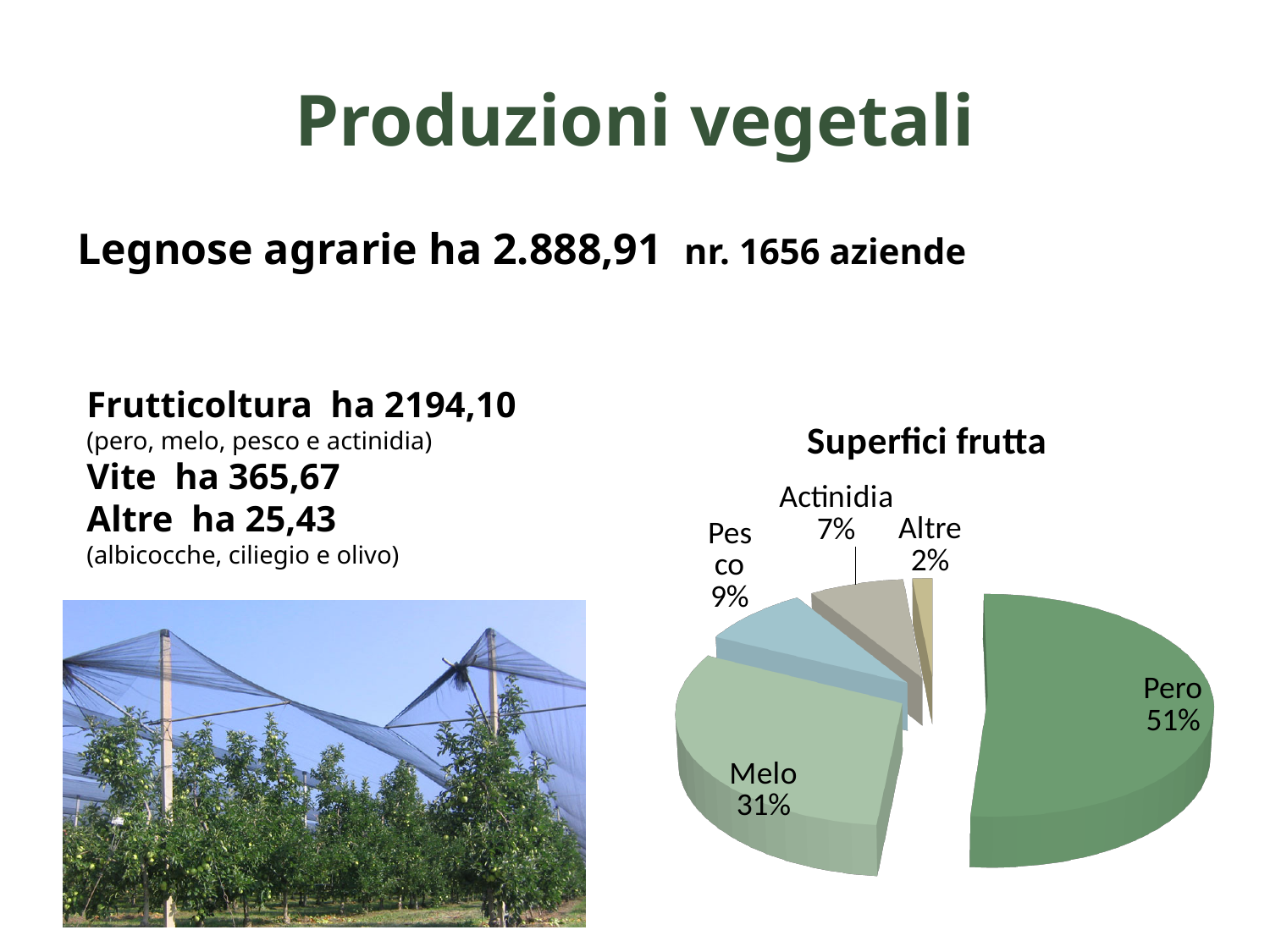
What is the title of the chart on the slide? Superfici frutta Which category has the largest slice of the pie? Pero What share of the pie does Melo represent? 31% How many slices does the pie chart have? 5 What share of the pie does Pesco represent? 9% What is the difference in percentage points between Pero and Melo? 20% What type of chart is shown under the title "Superfici frutta"? Pie chart Which category has the smallest slice of the pie? Altre What share of the pie does Actinidia represent? 7% What share of the pie does Altre represent? 2% Which slice is larger, Pesco or Actinidia? Pesco What share of the pie does Pero represent? 51%